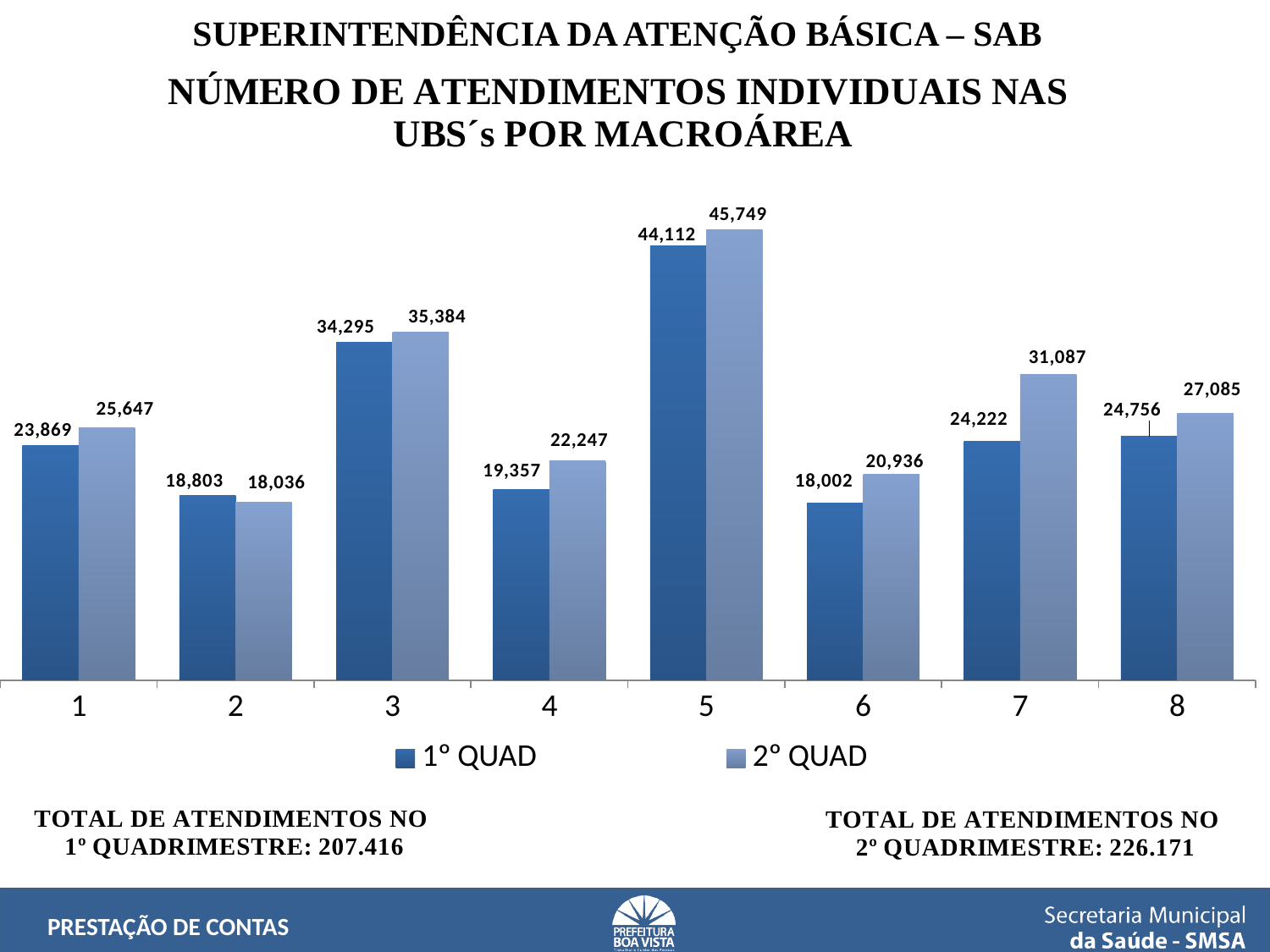
What is the difference between the 2° QUAD and 1° QUAD values for macroárea 5? 1,637 What kind of chart is shown on the slide? Bar chart How many macroáreas are shown on the x axis? 8 Which macroárea has the lowest value in the 1° QUAD series? 6 What is the value for macroárea 5 in the 1° QUAD series? 44,112 Which macroárea has the highest value in the 2° QUAD series? 5 For macroárea 2, which series has the larger value, 1° QUAD or 2° QUAD? 1° QUAD How many series does the legend list? 2 What is the value for macroárea 7 in the 2° QUAD series? 31,087 Which macroárea has the lowest value in the 2° QUAD series? 2 What is the difference between the 2° QUAD and 1° QUAD values for macroárea 7? 6,865 What is the value for macroárea 4 in the 2° QUAD series? 22,247